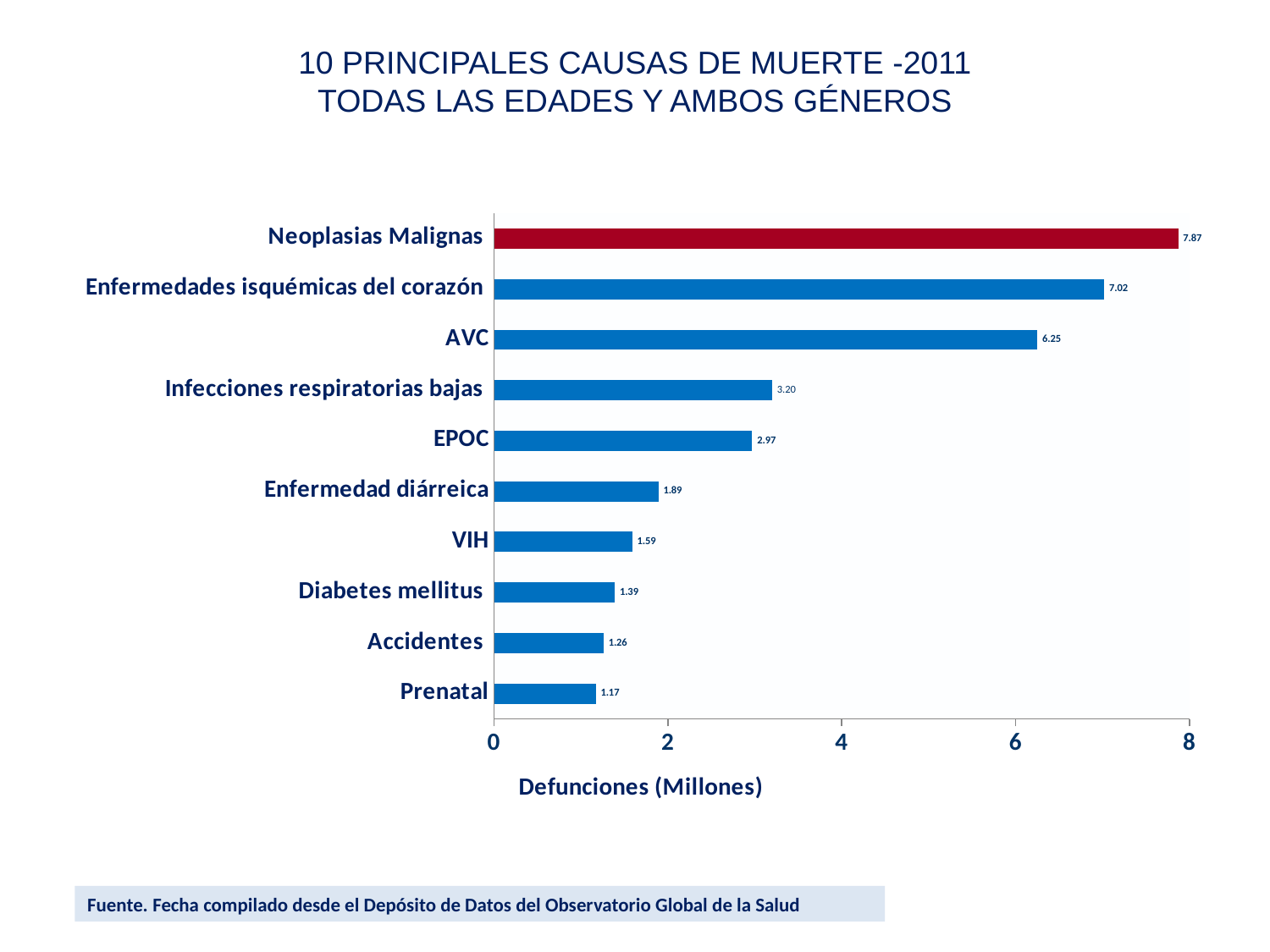
Which cause of death has the highest value? Neoplasias Malignas Which cause of death has the lowest value? Prenatal How many causes of death are shown in the chart? 10 Is the value for Enfermedad diárreica greater or less than 2? less Which is larger, the value for VIH or the value for Accidentes? VIH What is the value for AVC? 6.25 What is the value for Diabetes mellitus? 1.39 What is the difference between the values for Infecciones respiratorias bajas and EPOC? 0.23 What is the value for Neoplasias Malignas? 7.87 What kind of chart is shown on the slide? bar chart What is the difference between the values for Neoplasias Malignas and Enfermedades isquémicas del corazón? 0.85 What is the label of the horizontal axis? Defunciones (Millones)